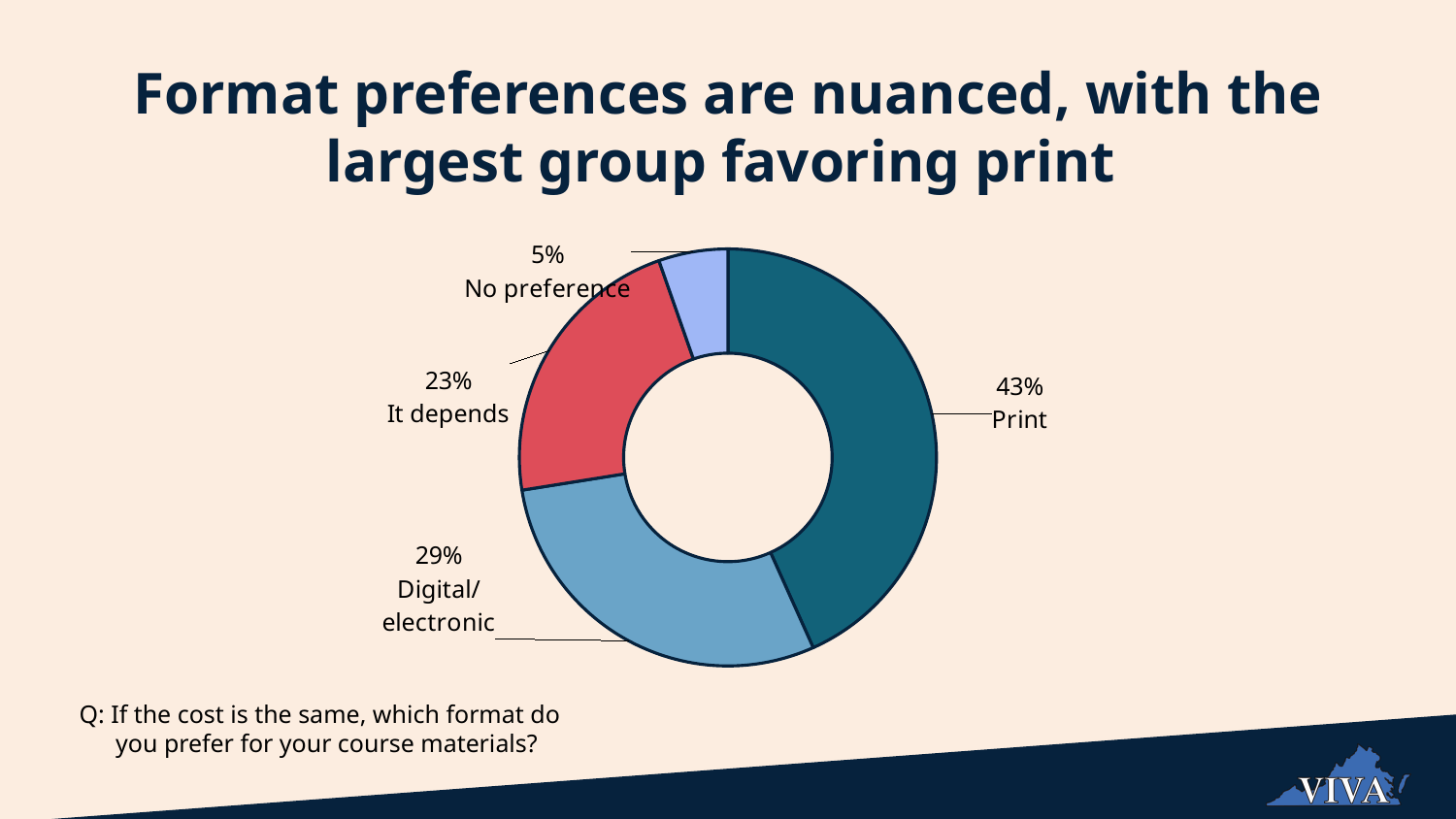
What percentage of respondents have no preference? 5% What is the combined share of Print and Digital/electronic? 72% What percentage of respondents prefer digital/electronic? 29% Which format preference has the largest share? Print Which response has the smallest share? No preference What percentage of respondents prefer print? 43% What is the difference in percentage points between Print and Digital/electronic? 14 What percentage of respondents answered 'It depends'? 23% What colour is the Print slice? Dark teal How many categories are shown in the chart? 4 What kind of chart is shown on the slide? Pie chart (donut) Which is larger, the share for 'It depends' or the share for Digital/electronic? Digital/electronic